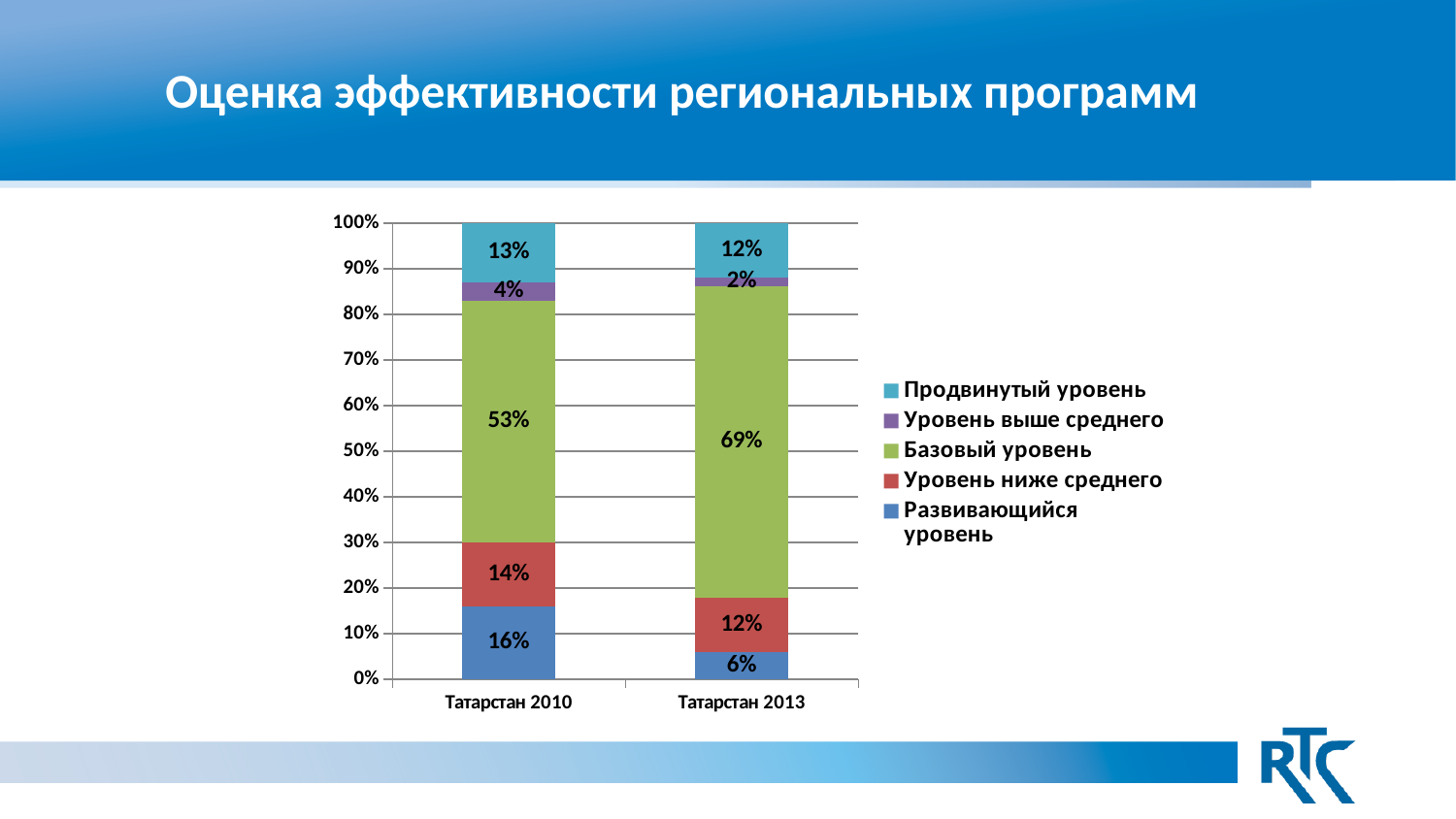
What is the value of Развивающийся уровень for Татарстан 2013? 6% How many series does the legend list? 5 What is the value of Уровень выше среднего for Татарстан 2010? 4% What kind of chart is shown on the slide? stacked bar chart What is the value of Базовый уровень for Татарстан 2010? 53% Which is larger: Развивающийся уровень for Татарстан 2010 or for Татарстан 2013? Татарстан 2010 What is the difference between the Базовый уровень values for Татарстан 2013 and Татарстан 2010? 16% Which series has the smallest share in the Татарстан 2013 bar? Уровень выше среднего What is the title of the slide? Оценка эффективности региональных программ How many categories are shown on the x axis? 2 What is the value of Базовый уровень for Татарстан 2013? 69% Which series has the largest share in the Татарстан 2013 bar? Базовый уровень